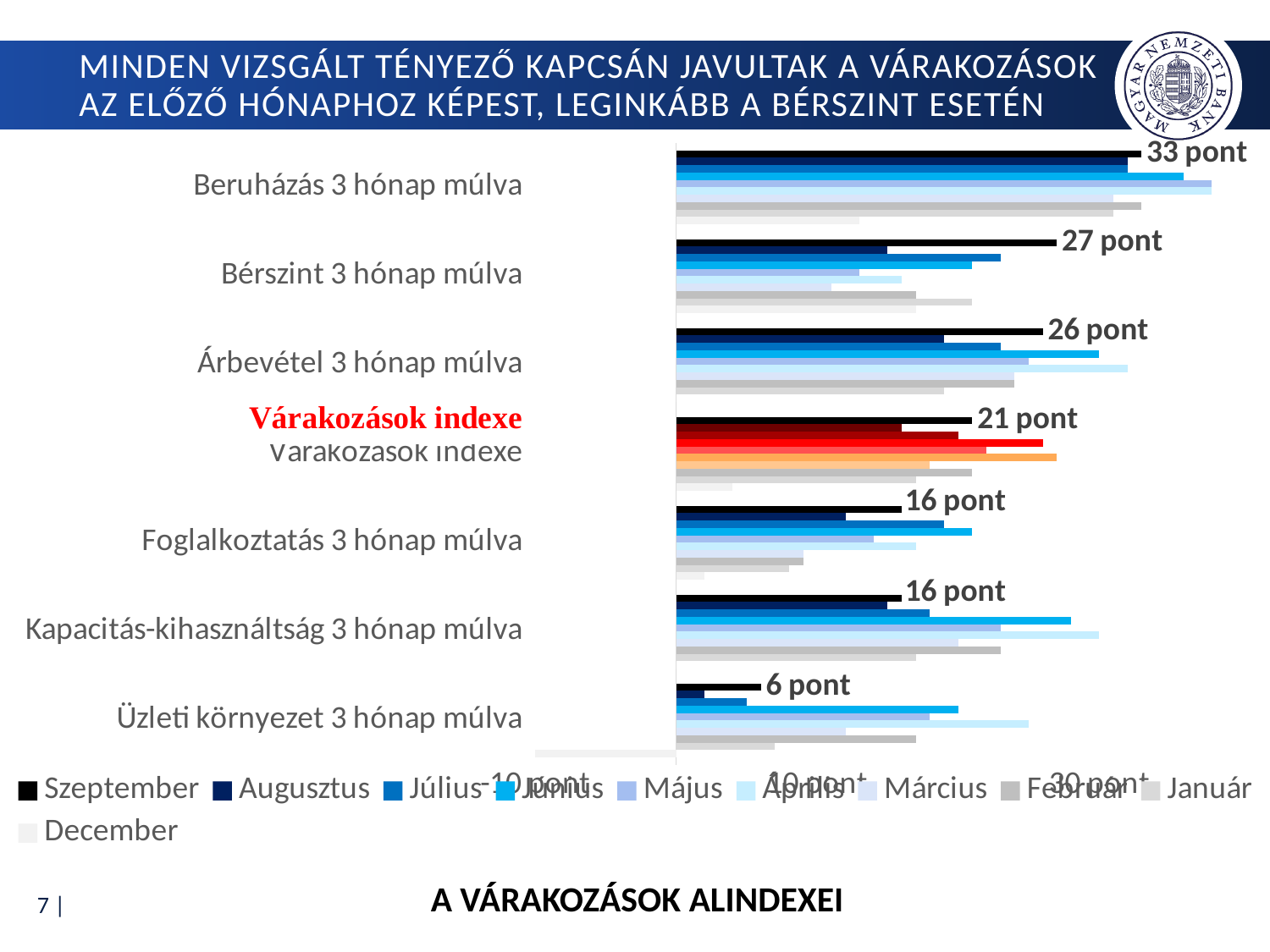
What is the title of the chart? A VÁRAKOZÁSOK ALINDEXEI What is the Szeptember value for Beruházás 3 hónap múlva? 33 pont What is the Szeptember value for Bérszint 3 hónap múlva? 27 pont What is the Szeptember value for Üzleti környezet 3 hónap múlva? 6 pont How many categories are shown on the chart? 7 Which category has the lowest Szeptember value? Üzleti környezet 3 hónap múlva Which category has the highest Szeptember value? Beruházás 3 hónap múlva What kind of chart is shown on the slide? Bar chart What is the difference between the Szeptember values for Beruházás 3 hónap múlva and Bérszint 3 hónap múlva? 6 pont What is the Szeptember value for Várakozások indexe? 21 pont How many series does the legend list? 10 Which has the larger Szeptember value, Árbevétel 3 hónap múlva or Foglalkoztatás 3 hónap múlva? Árbevétel 3 hónap múlva